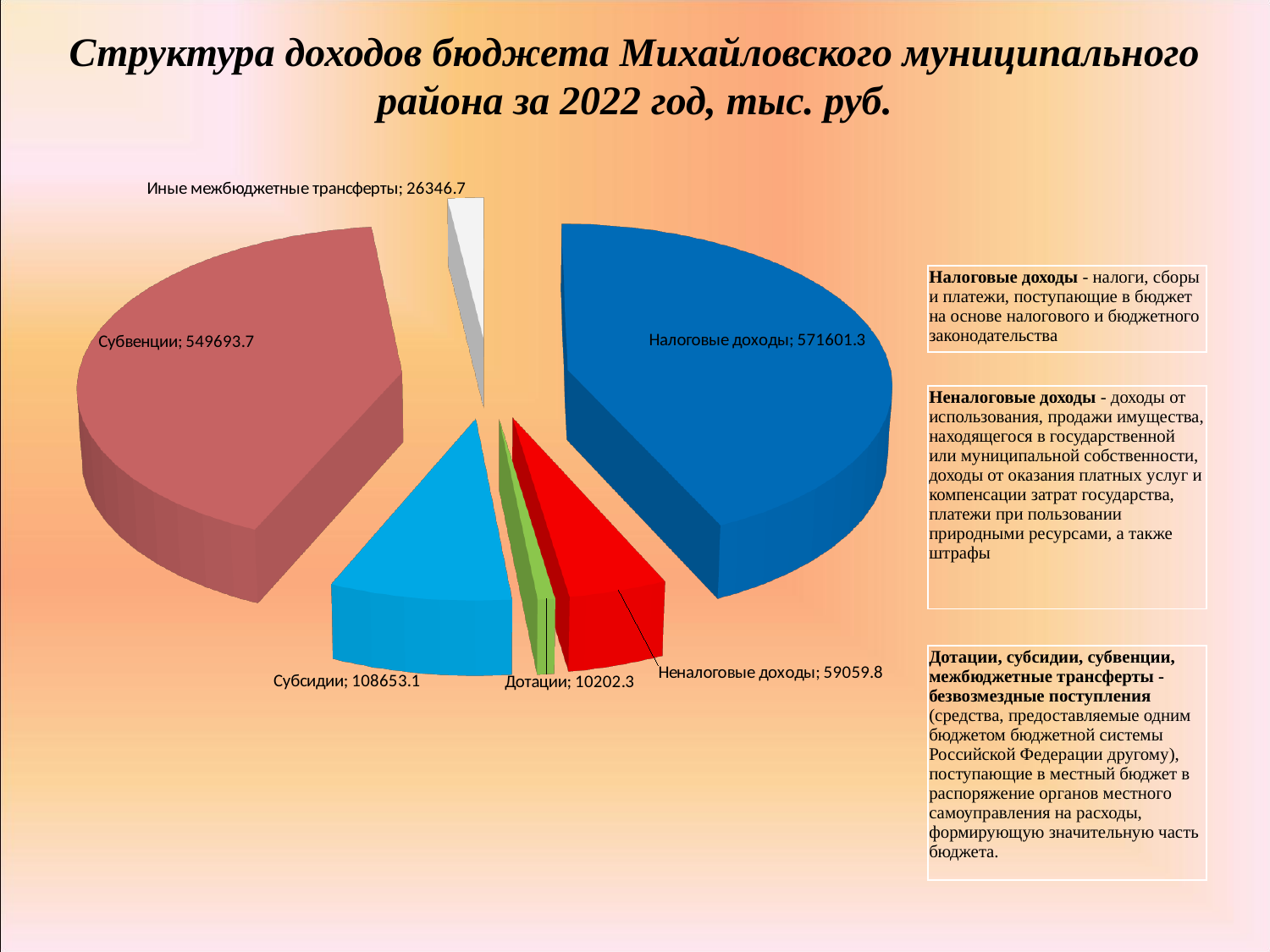
What is the value for Налоговые доходы? 571601.3 What type of chart is shown on the slide? Pie chart What is the value for Субсидии? 108653.1 What is the value for Дотации? 10202.3 Which category has the smallest value in the pie chart? Дотации What is the value for Субвенции? 549693.7 How many categories (slices) does the pie chart have? 6 Which is larger, Субсидии or Неналоговые доходы? Субсидии Which category has the largest value in the pie chart? Налоговые доходы What is the title of the chart on the slide? Структура доходов бюджета Михайловского муниципального района за 2022 год, тыс. руб. What is the difference between Налоговые доходы and Субвенции? 21907.6 What is the value for Иные межбюджетные трансферты? 26346.7